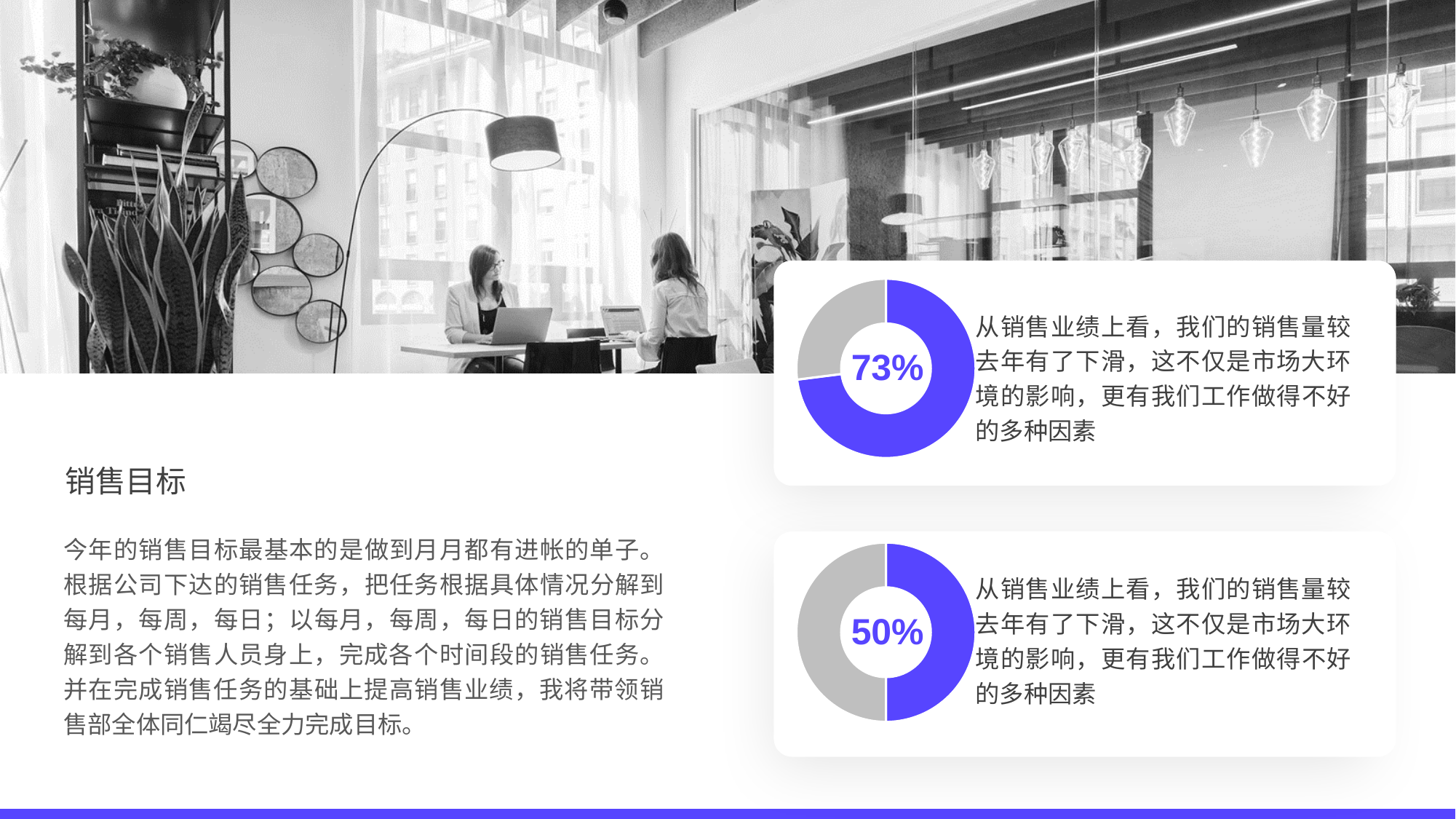
What percentage is displayed in the centre of the top donut chart? 73% In the top donut chart, what share of the ring does the purple segment represent? 73% How many donut charts are on the slide? 2 What percentage is displayed in the centre of the bottom donut chart? 50% Is the value shown in the top donut chart greater or less than 50%? greater What kind of chart is shown in the top card on the right side of the slide? Donut (pie) chart What colour is the remaining (unfilled) portion of the ring in the donut charts? Grey Which donut chart shows the larger percentage, the top one or the bottom one? The top one (73%) What is the difference between the percentage in the top donut chart and the percentage in the bottom donut chart? 23% What colour is the filled (highlighted) segment in both donut charts? Purple